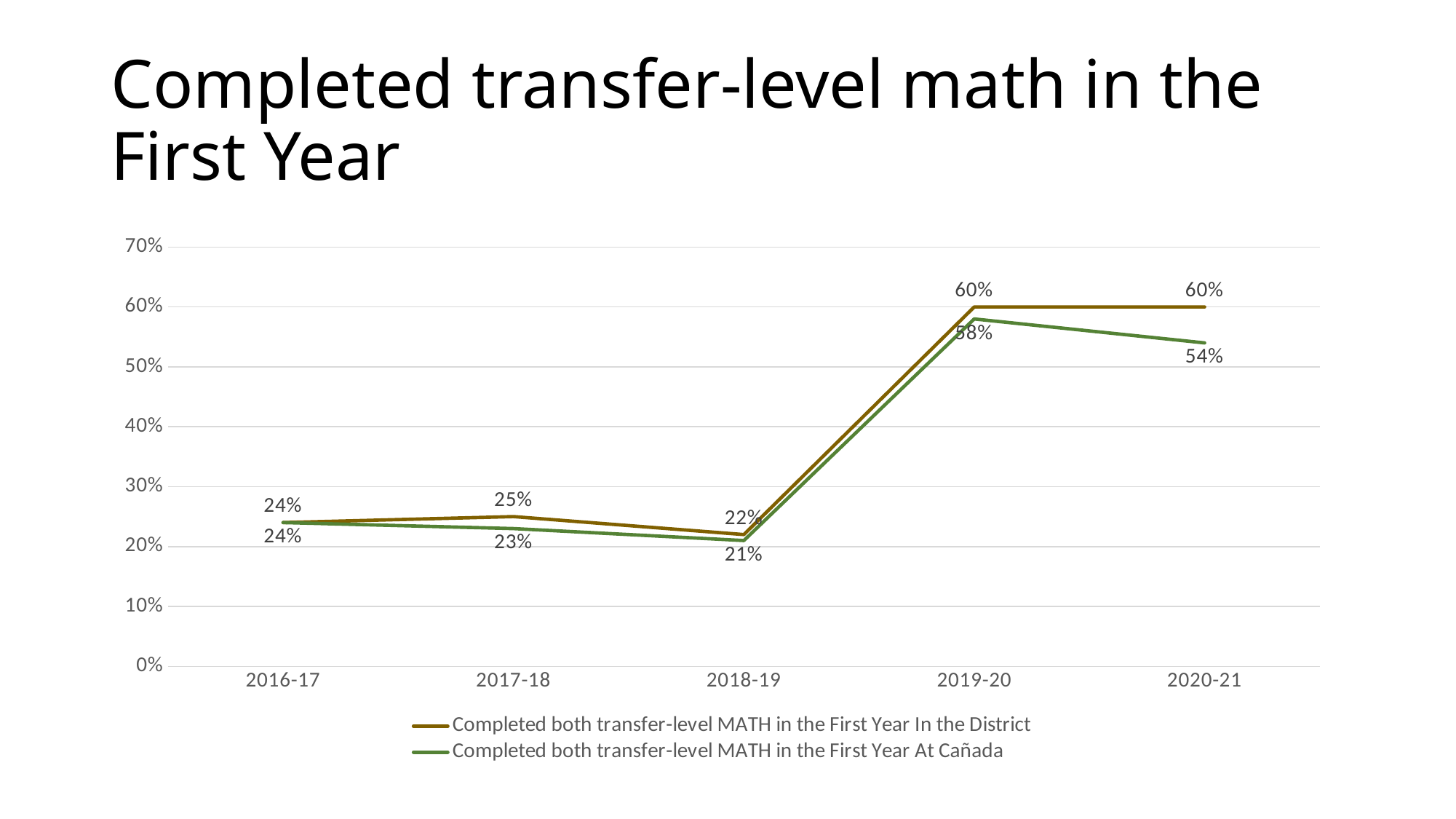
What is the value for 'At Cañada' in 2017-18? 23% Does the 'At Cañada' series rise or fall from 2019-20 to 2020-21? Fall What is the difference between the 'In the District' and 'At Cañada' values in 2020-21? 6% What is the value for 'In the District' in 2019-20? 60% What is the value for 'At Cañada' in 2020-21? 54% How many academic years are plotted along the x axis? 5 In which year is the 'At Cañada' value lowest? 2018-19 Which series has the larger value in 2018-19, 'In the District' or 'At Cañada'? In the District In which year is the 'At Cañada' value highest? 2019-20 What is the title of the slide? Completed transfer-level math in the First Year What type of chart is shown on the slide? Line chart How many series does the legend list? 2